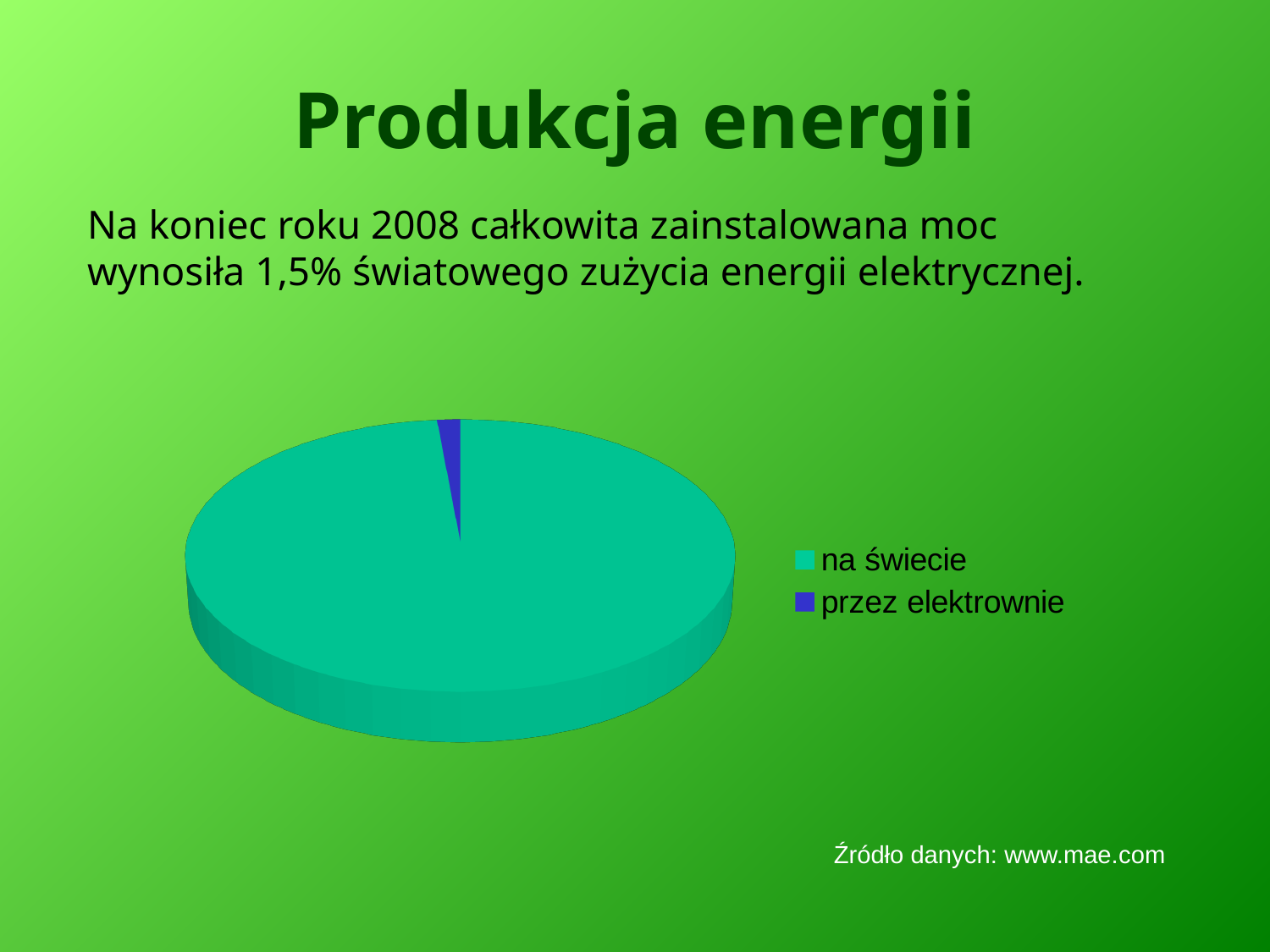
Which slice of the pie chart is the largest? na świecie Which slice of the pie chart is the smallest? przez elektrownie What kind of chart is shown on the slide? pie chart What colour is the "przez elektrownie" slice in the pie chart? blue What is the title of the slide containing the pie chart? Produkcja energii Which is larger in the pie chart, "na świecie" or "przez elektrownie"? na świecie How many slices does the pie chart have? 2 How many entries does the legend of the pie chart list? 2